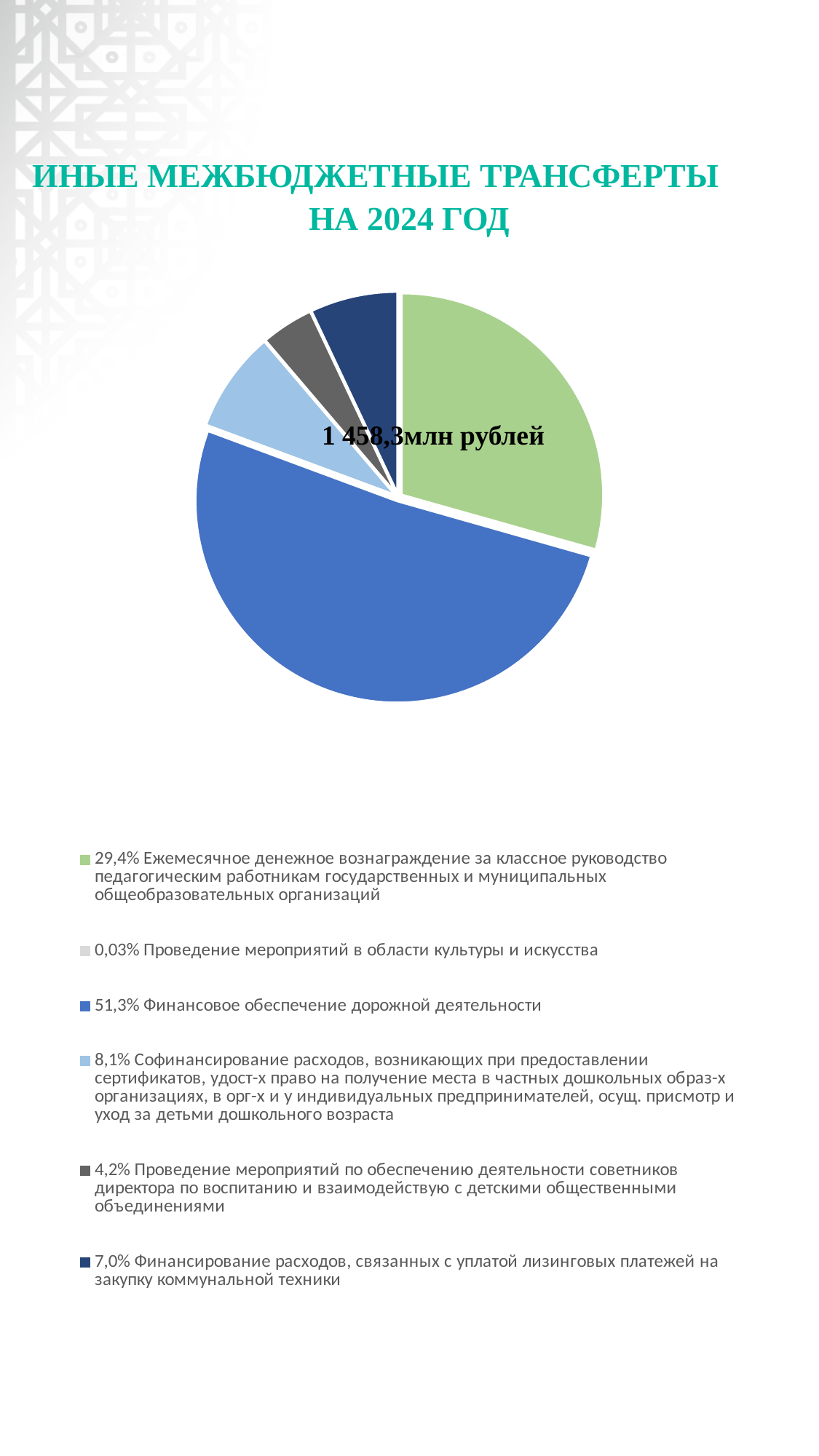
Which category has the largest share of the pie? Финансовое обеспечение дорожной деятельности Which is larger: the share for "Софинансирование расходов..." (8,1%) or the share for "Финансирование расходов, связанных с уплатой лизинговых платежей..." (7,0%)? Софинансирование расходов... (8,1%) What kind of chart is shown on the slide? pie chart How many categories does the legend list? 6 What share of the pie does "Ежемесячное денежное вознаграждение за классное руководство педагогическим работникам государственных и муниципальных общеобразовательных организаций" represent? 29,4% What total amount is printed in the centre of the pie chart? 1 458,3млн рублей What is the difference in percentage points between "Финансовое обеспечение дорожной деятельности" (51,3%) and "Ежемесячное денежное вознаграждение за классное руководство..." (29,4%)? 21,9 Which category has the smallest share of the pie? Проведение мероприятий в области культуры и искусства What share of the pie does "Финансовое обеспечение дорожной деятельности" represent? 51,3% What percentage is shown for "Проведение мероприятий в области культуры и искусства"? 0,03% What percentage is shown for "Финансирование расходов, связанных с уплатой лизинговых платежей на закупку коммунальной техники"? 7,0% What is the title of the slide above the chart? ИНЫЕ МЕЖБЮДЖЕТНЫЕ ТРАНСФЕРТЫ НА 2024 ГОД